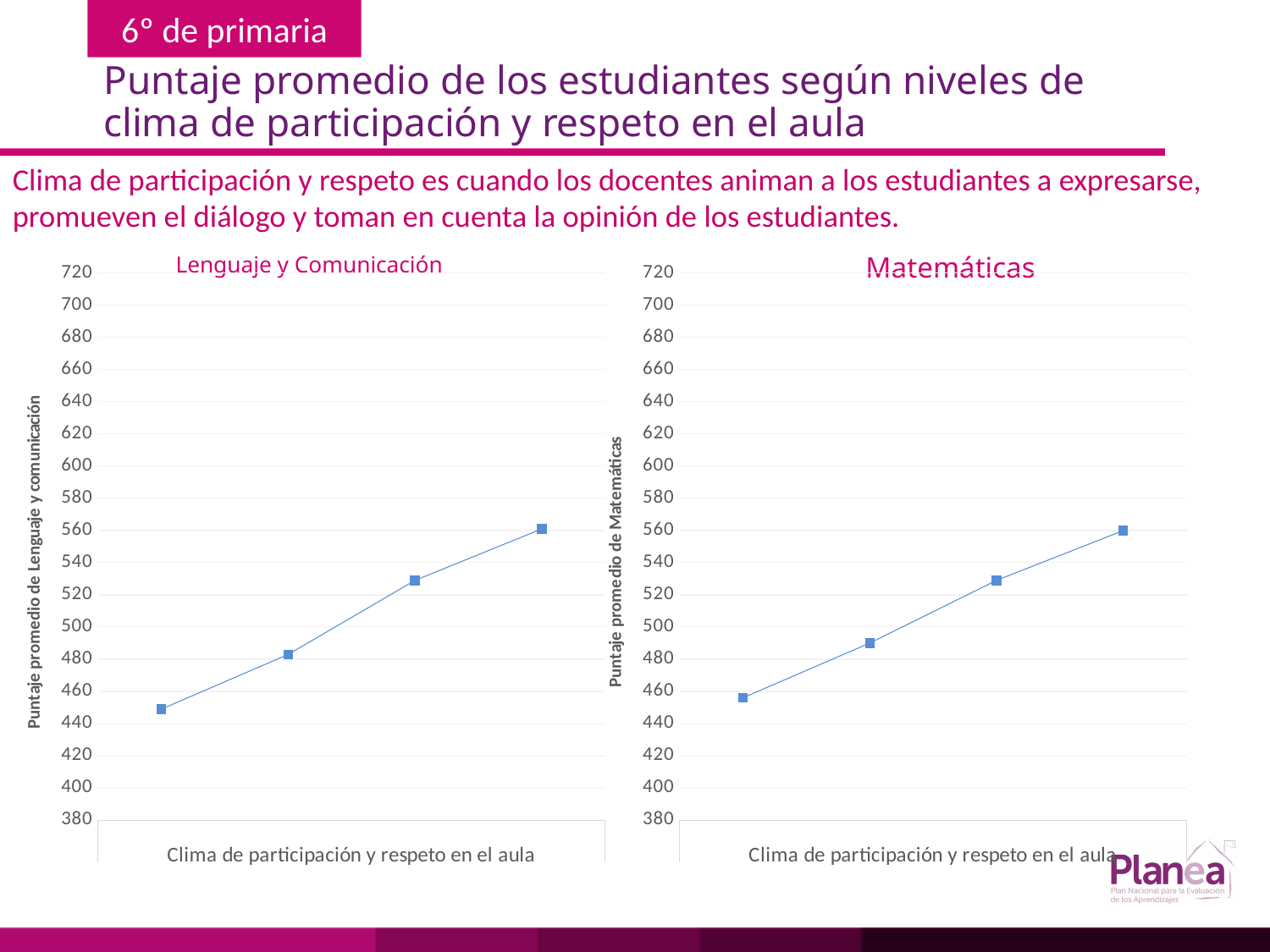
How many data points are plotted in the Matemáticas chart? 4 In the Matemáticas chart, do the values rise or fall from left to right along the x axis? rise What kind of chart is the Matemáticas chart? line chart What is the y-axis label of the Matemáticas chart? Puntaje promedio de Matemáticas In the Matemáticas chart, which point has the highest value, the leftmost or the rightmost? rightmost In the Matemáticas chart, is the value of the rightmost point greater or less than 540? greater In the Matemáticas chart, is the value of the leftmost point greater or less than 480? less How many data points are plotted in the Lenguaje y Comunicación chart? 4 In the Lenguaje y Comunicación chart, do the values rise or fall from left to right along the x axis? rise In the Lenguaje y Comunicación chart, is the value of the leftmost point greater or less than 460? less What kind of chart is the Lenguaje y Comunicación chart? line chart